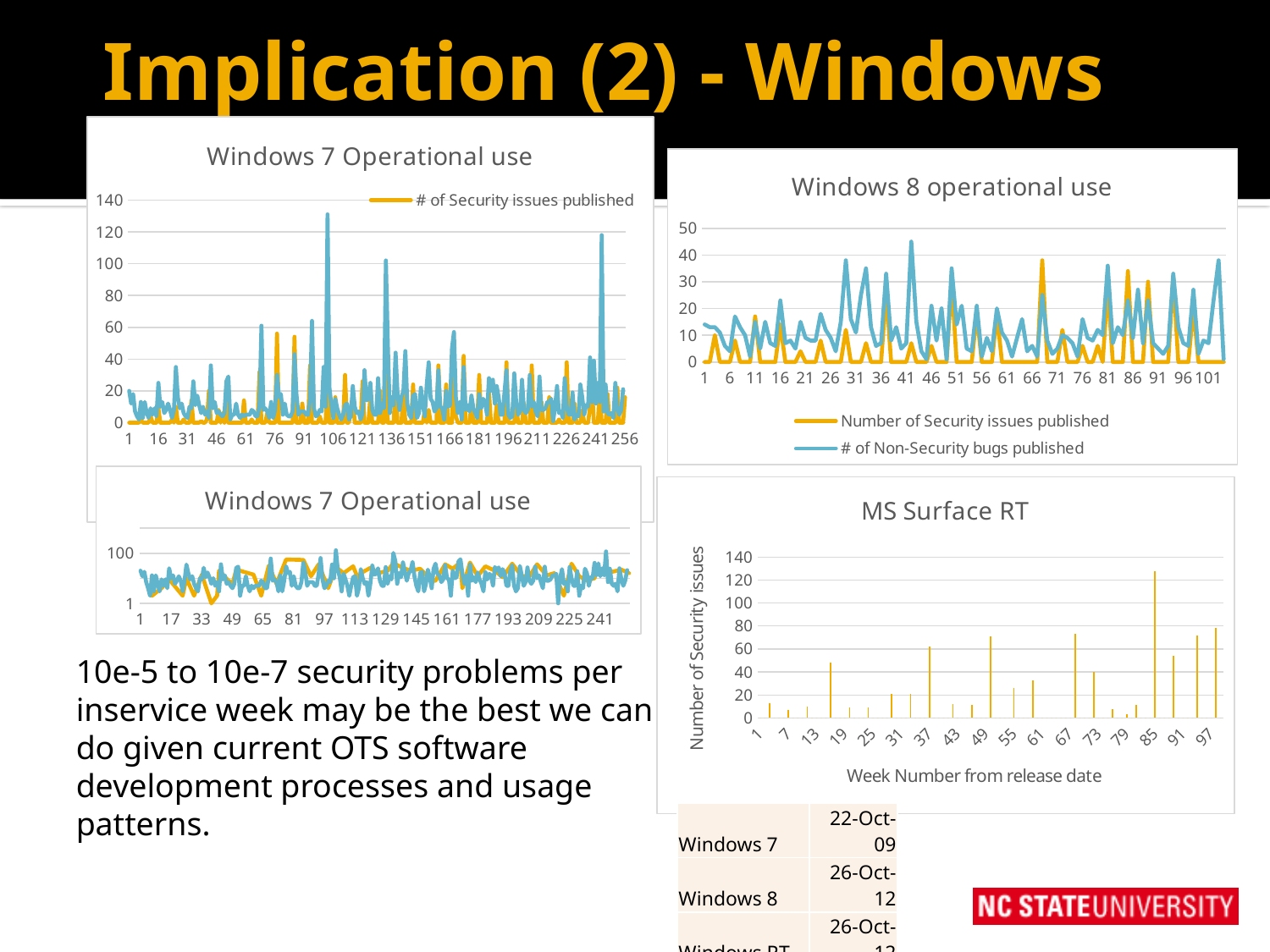
In the top-left Windows 7 Operational use chart, is the highest peak of the blue line greater or less than 100? greater In the top-left Windows 7 Operational use chart, is the highest value of # of Security issues published greater or less than 80? less In the MS Surface RT chart, is the bar at week 19 greater or less than 60? less What kind of chart is the Windows 8 operational use chart? line chart What are the two legend entries in the Windows 8 operational use chart? Number of Security issues published; # of Non-Security bugs published What is the y-axis title of the MS Surface RT chart? Number of Security issues What kind of chart is the MS Surface RT chart? bar chart How many series does the legend of the Windows 8 operational use chart list? 2 How many series does the legend of the top-left Windows 7 Operational use chart list? 1